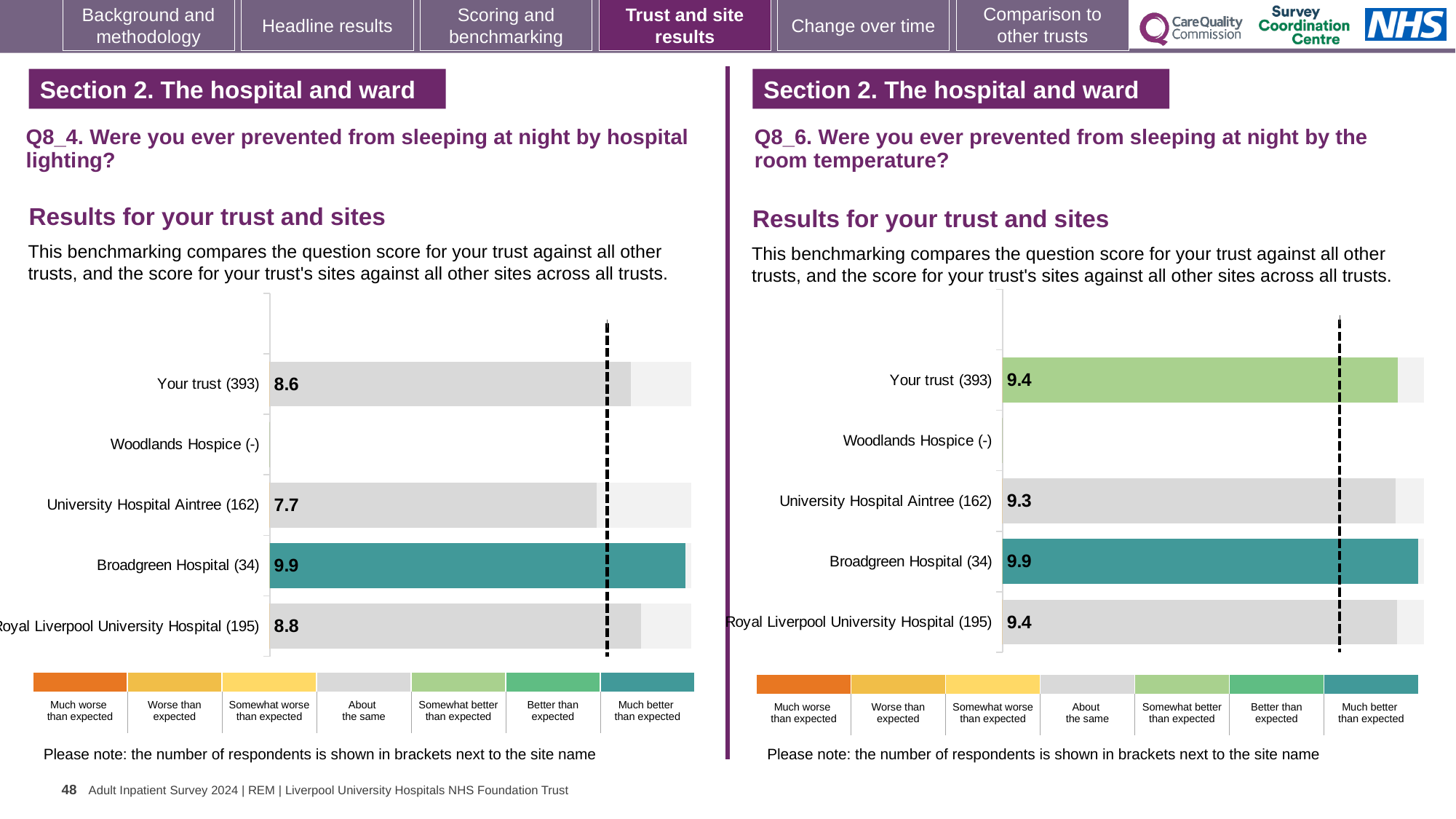
In the Q8_4 hospital lighting chart, what is the score for University Hospital Aintree (162)? 7.7 In the Q8_4 hospital lighting chart, which site has the highest score? Broadgreen Hospital (34) What kind of chart is used in the Q8_4 hospital lighting chart? Bar chart In the Q8_6 room temperature chart, how many site rows are listed on the vertical axis, including Your trust? 5 In the Q8_6 room temperature chart, what is the score for Your trust (393)? 9.4 In the Q8_4 hospital lighting chart, which site has the lowest score? University Hospital Aintree (162) In the Q8_4 hospital lighting chart, what is the difference between the scores for Broadgreen Hospital (34) and University Hospital Aintree (162)? 2.2 In the Q8_4 hospital lighting chart, what is the score for Your trust (393)? 8.6 In the Q8_6 room temperature chart, what is the score for Broadgreen Hospital (34)? 9.9 In the Q8_6 room temperature chart, which site has the highest score? Broadgreen Hospital (34) In the Q8_4 hospital lighting chart, which has the higher score: Royal Liverpool University Hospital (195) or Your trust (393)? Royal Liverpool University Hospital (195) In the Q8_6 room temperature chart, what is the difference between the scores for Broadgreen Hospital (34) and University Hospital Aintree (162)? 0.6